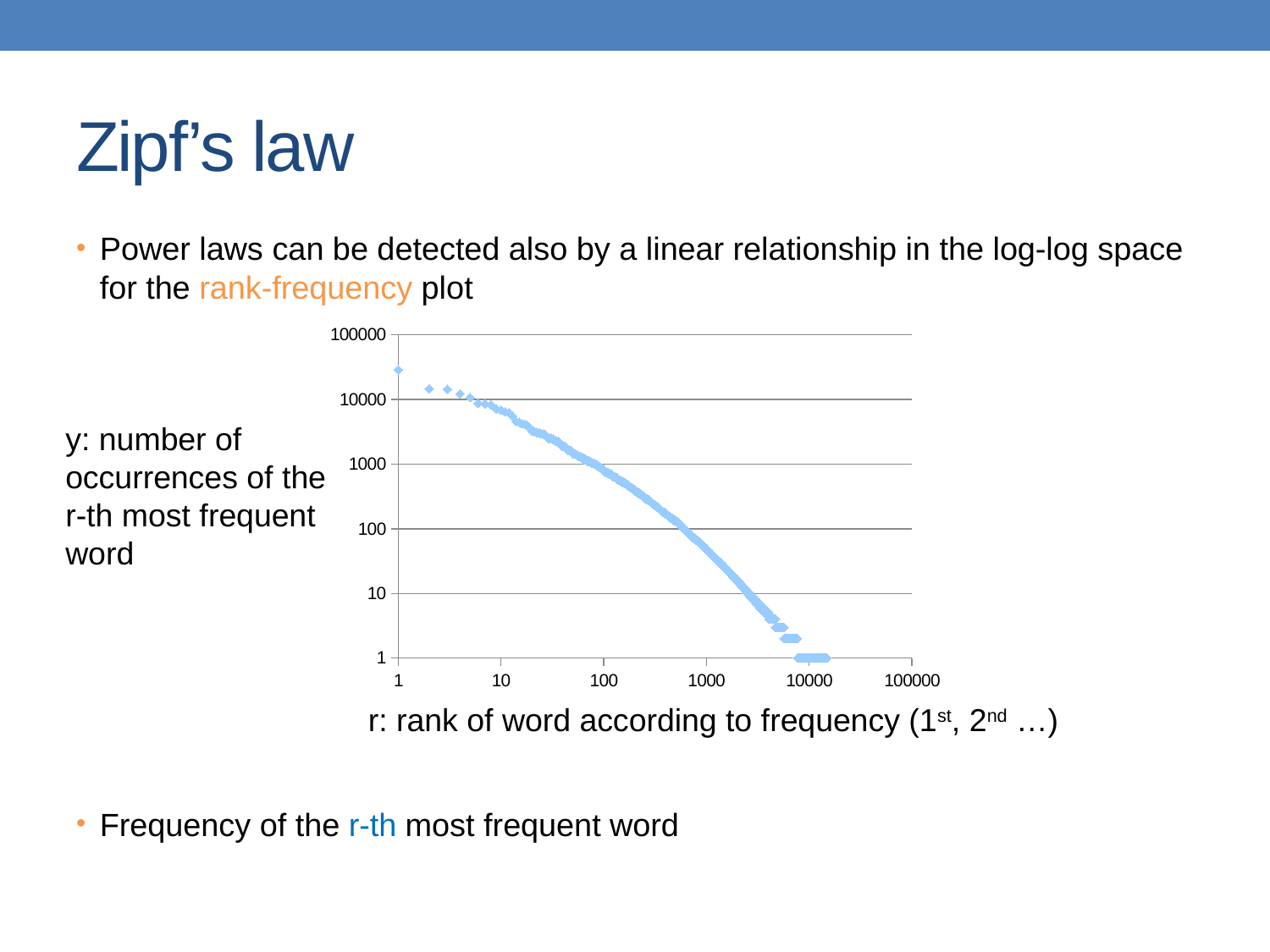
Is the number of occurrences for the word of rank 100 greater or less than 10000? less Is the number of occurrences for the word of rank 1 greater or less than 10000? greater Is the number of occurrences for the word of rank 10000 greater or less than 10? less What is the highest value shown on the y axis? 100000 What kind of chart is shown on the slide? scatter chart What does the x axis of the chart represent? r: rank of word according to frequency As the rank of the word increases along the x axis, does the number of occurrences rise or fall? fall What is the lowest number of occurrences reached by the plotted points? 1